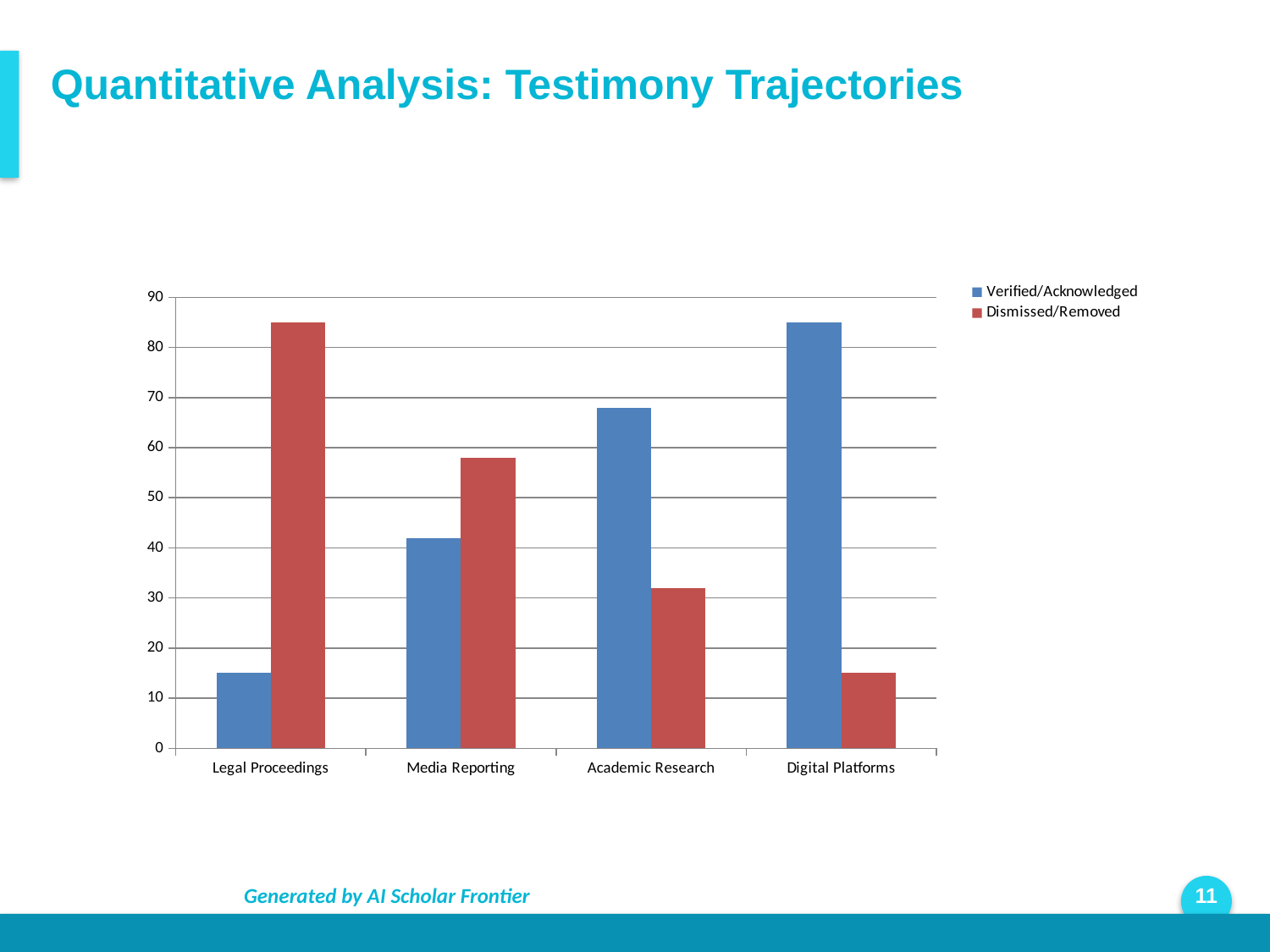
Which category has the highest Verified/Acknowledged value? Digital Platforms Is the Verified/Acknowledged value for Media Reporting greater or less than 50? less Do the Verified/Acknowledged values rise or fall from Legal Proceedings to Digital Platforms? rise Is the Dismissed/Removed value for Legal Proceedings greater or less than 80? greater How many series does the legend list? 2 Is the Dismissed/Removed value for Academic Research greater or less than 40? less Which category has the lowest Verified/Acknowledged value? Legal Proceedings Which category has the lowest Dismissed/Removed value? Digital Platforms Which category has the highest Dismissed/Removed value? Legal Proceedings How many categories are shown on the x axis? 4 For Academic Research, which is larger: Verified/Acknowledged or Dismissed/Removed? Verified/Acknowledged What kind of chart is shown on the slide? bar chart